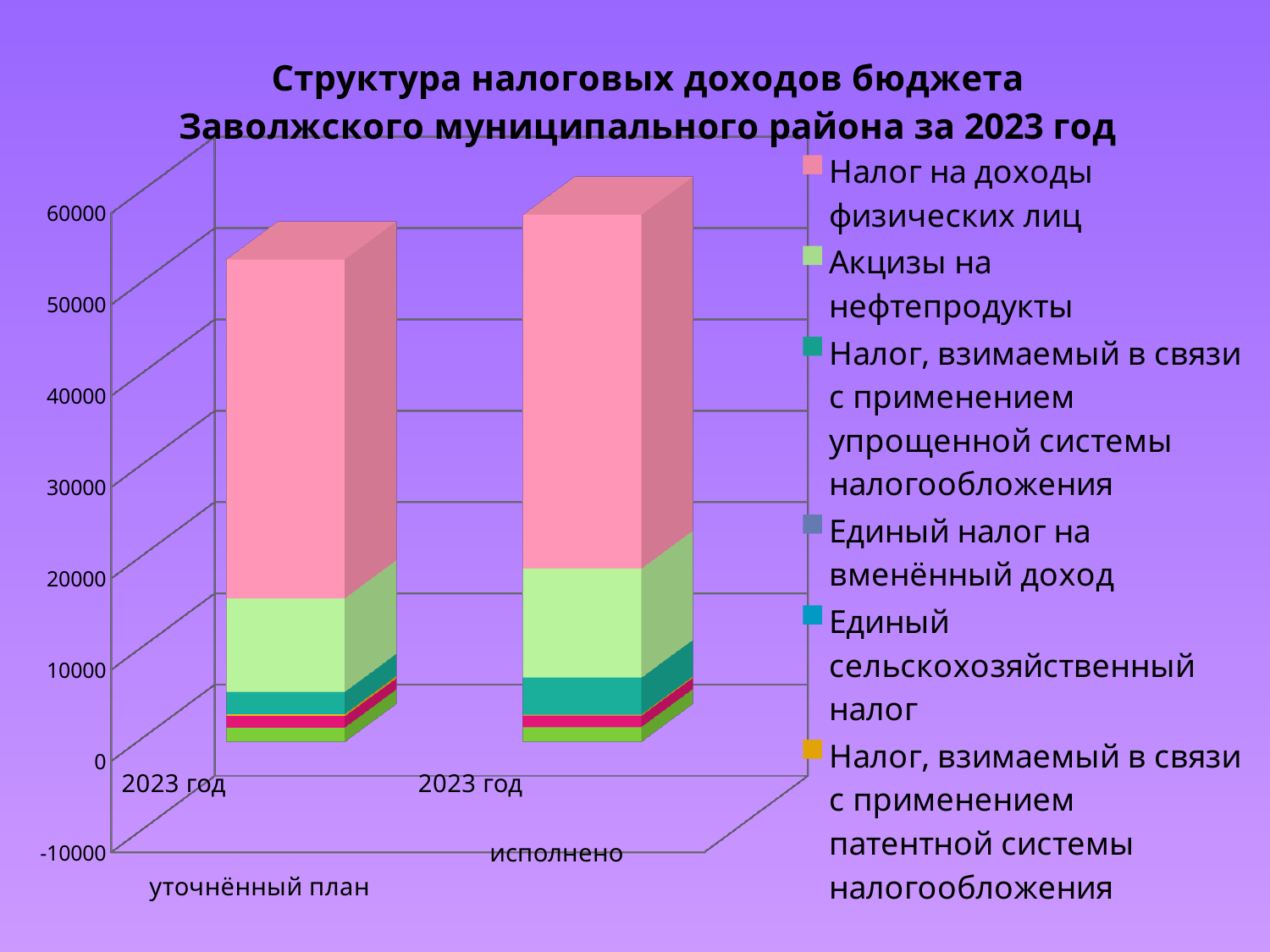
How many series does the legend list? 6 What kind of chart is shown on the slide? Stacked bar chart Is the total for the 'исполнено' bar greater or less than 50000? greater Which bar is taller, 'уточнённый план' or 'исполнено'? исполнено Is the total for the 'уточнённый план' bar greater or less than 60000? less Which series is the second-largest segment in the 'исполнено' bar? Акцизы на нефтепродукты Is the total for the 'уточнённый план' bar greater or less than 40000? greater What is the title of the chart? Структура налоговых доходов бюджета Заволжского муниципального района за 2023 год What is the highest value shown on the vertical axis? 60000 Which series makes up the largest segment of each bar? Налог на доходы физических лиц Which colour represents 'Налог на доходы физических лиц' in the legend? Pink How many bars are plotted in the chart? 2